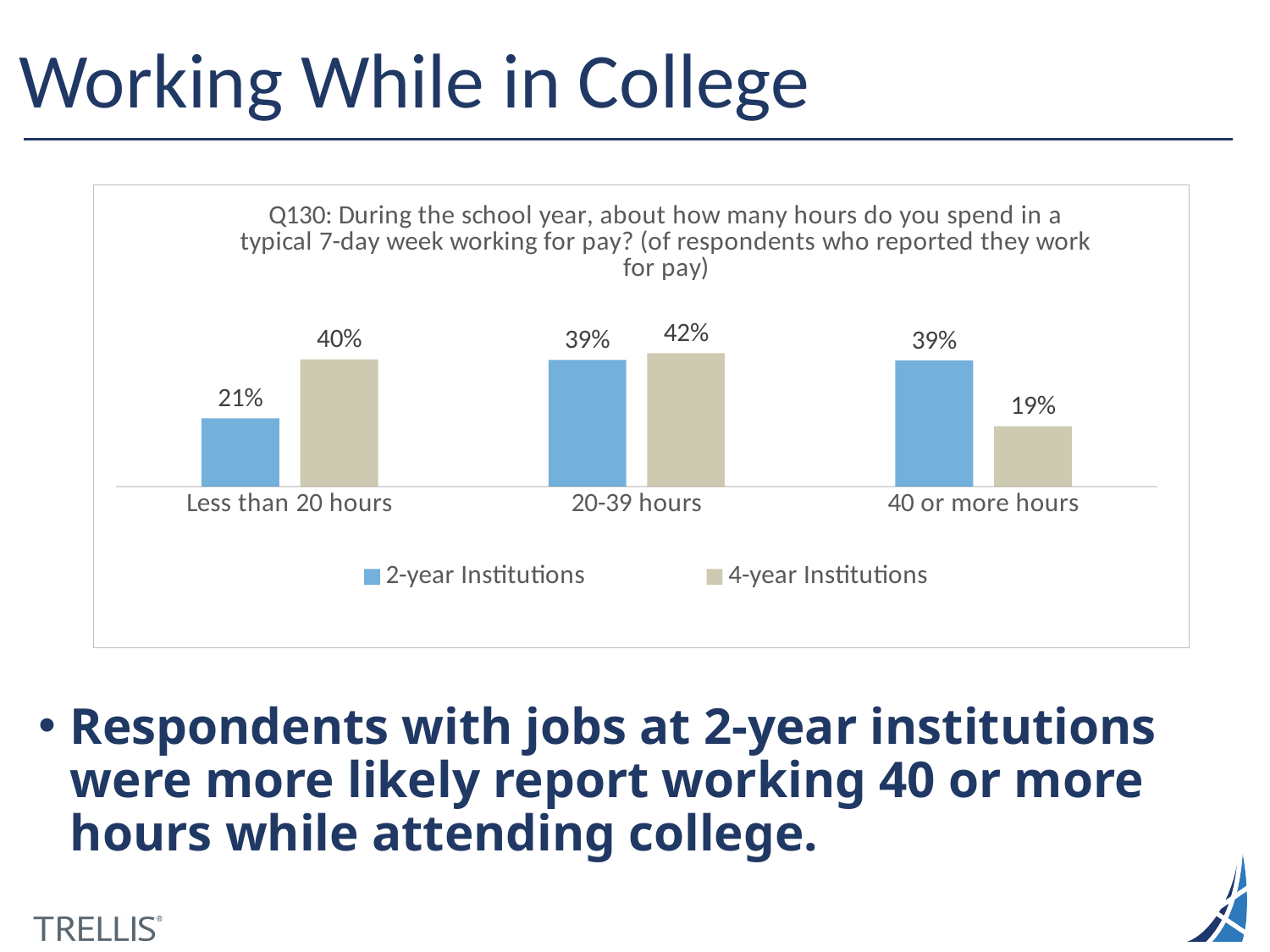
Which hours category has the highest value for 4-year institutions? 20-39 hours What kind of chart is shown on the slide? Bar chart How many series does the legend list? 2 For 40 or more hours, which is larger: the 2-year institutions value or the 4-year institutions value? 2-year Institutions What is the difference between the 2-year and 4-year institution values for 40 or more hours? 20% Which colour represents 2-year Institutions in the chart? Blue What percentage of respondents at 4-year institutions reported working 20-39 hours? 42% How many hours categories are shown on the x axis? 3 What percentage of respondents at 2-year institutions reported working less than 20 hours? 21% What is the difference between the 4-year and 2-year institution values for less than 20 hours? 19% What percentage of respondents at 4-year institutions reported working 40 or more hours? 19% Which hours category has the lowest value for 2-year institutions? Less than 20 hours